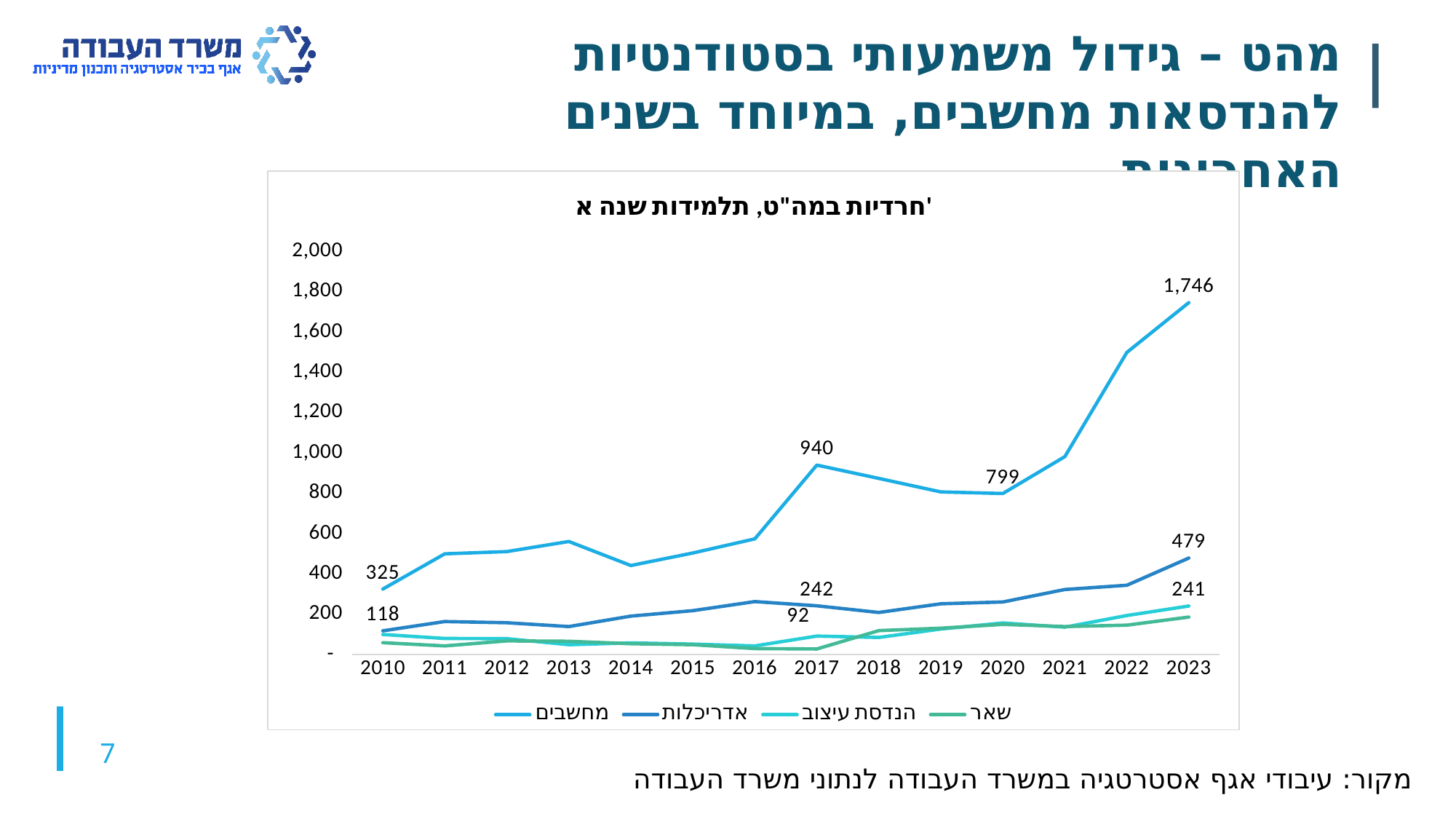
What is the difference between the מחשבים values in 2023 and 2010? 1,421 How many series does the legend list? 4 Is the value for מחשבים in 2021 greater or less than 800? greater What type of chart is shown on the slide? line chart What is the difference between the אדריכלות values in 2023 and 2010? 361 How many years are shown on the x axis? 14 What is the value for מחשבים in 2017? 940 What is the value for מחשבים in 2023? 1,746 What is the value for אדריכלות in 2023? 479 What is the value for מחשבים in 2020? 799 What is the value for מחשבים in 2010? 325 Which series has the highest value in 2023? מחשבים